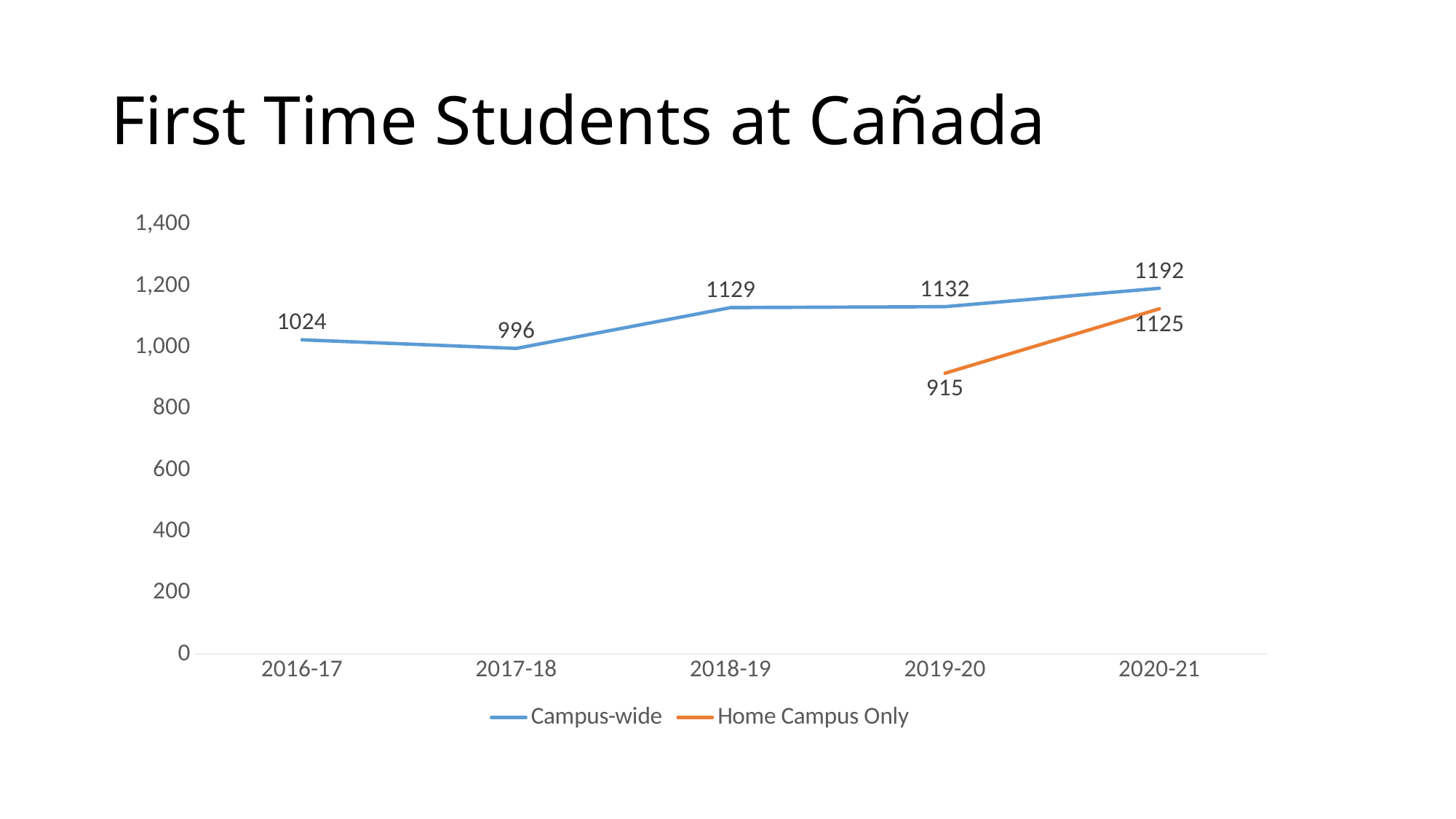
What is the Campus-wide value for 2016-17? 1024 How many series does the legend list? 2 What is the Home Campus Only value for 2019-20? 915 Does the Home Campus Only series rise or fall from 2019-20 to 2020-21? Rise In which year is the Campus-wide value lowest? 2017-18 How many years are shown on the x axis? 5 What is the Home Campus Only value for 2020-21? 1125 What kind of chart is shown on the slide? Line chart Which is larger in 2019-20, the Campus-wide value or the Home Campus Only value? Campus-wide What is the difference between the Campus-wide and Home Campus Only values in 2020-21? 67 In which year is the Campus-wide value highest? 2020-21 What is the Campus-wide value for 2017-18? 996